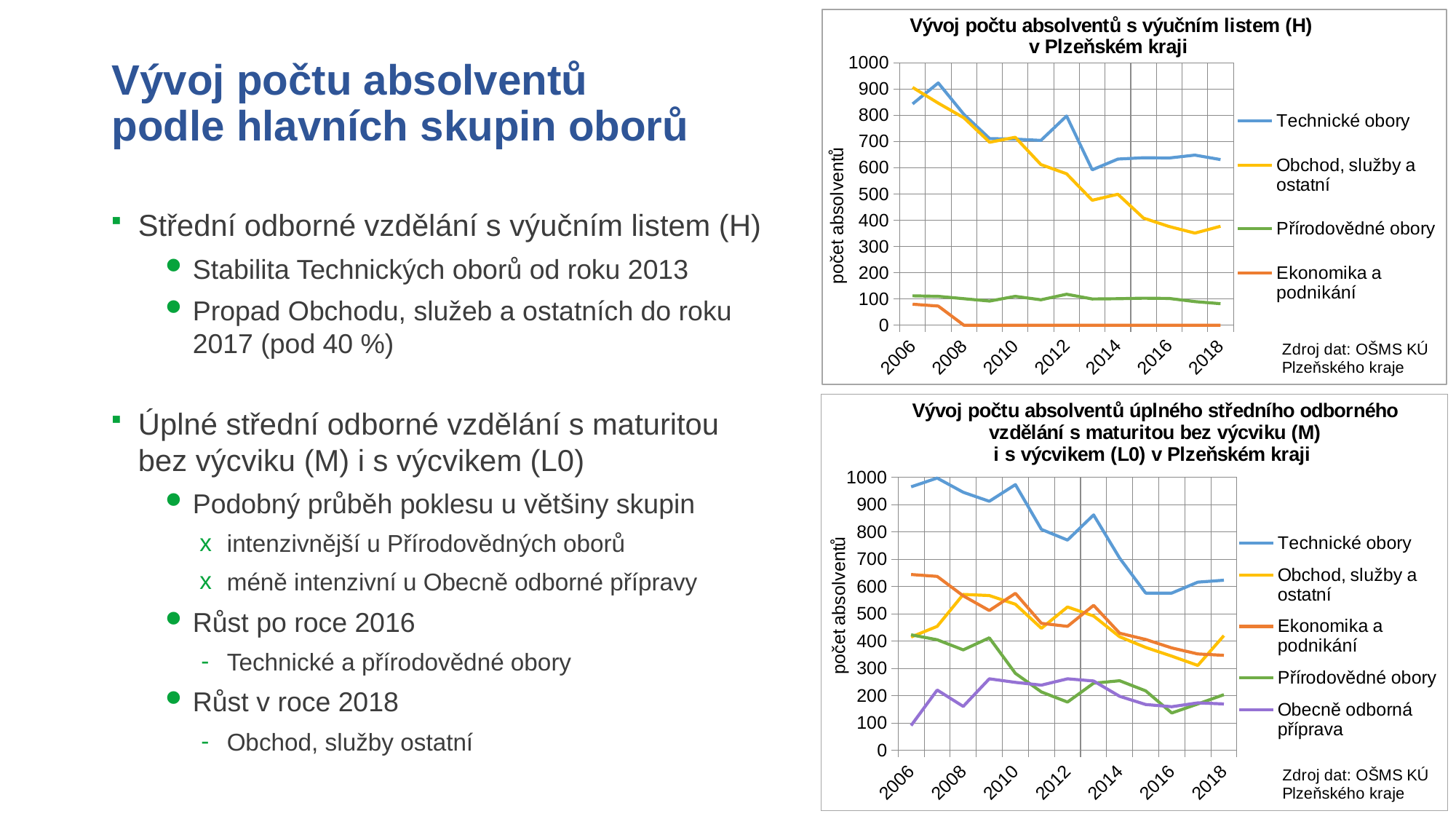
In the top chart (výuční list (H)), does the value for Obchod, služby a ostatní rise or fall from 2006 to 2017? fall In the bottom chart (maturita (M) and (L0)), is the value for Technické obory in 2016 greater or less than 500? greater In the top chart (výuční list (H)), is the value for Obchod, služby a ostatní in 2018 greater or less than 400? less How many series does the legend of the bottom chart (maturita (M) and (L0)) list? 5 What is the label of the vertical axis on the top chart (výuční list (H))? počet absolventů In the bottom chart (maturita (M) and (L0)), does the value for Technické obory rise or fall from 2007 to 2016? fall What kind of chart is the top chart, 'Vývoj počtu absolventů s výučním listem (H) v Plzeňském kraji'? line chart In the bottom chart (maturita (M) and (L0)), which series has the higher value in 2006: Technické obory or Ekonomika a podnikání? Technické obory In the top chart (výuční list (H)), is the value for Technické obory in 2018 greater or less than 600? greater In the top chart (výuční list (H)), which series has the higher value in 2018: Technické obory or Obchod, služby a ostatní? Technické obory How many series does the legend of the top chart (výuční list (H)) list? 4